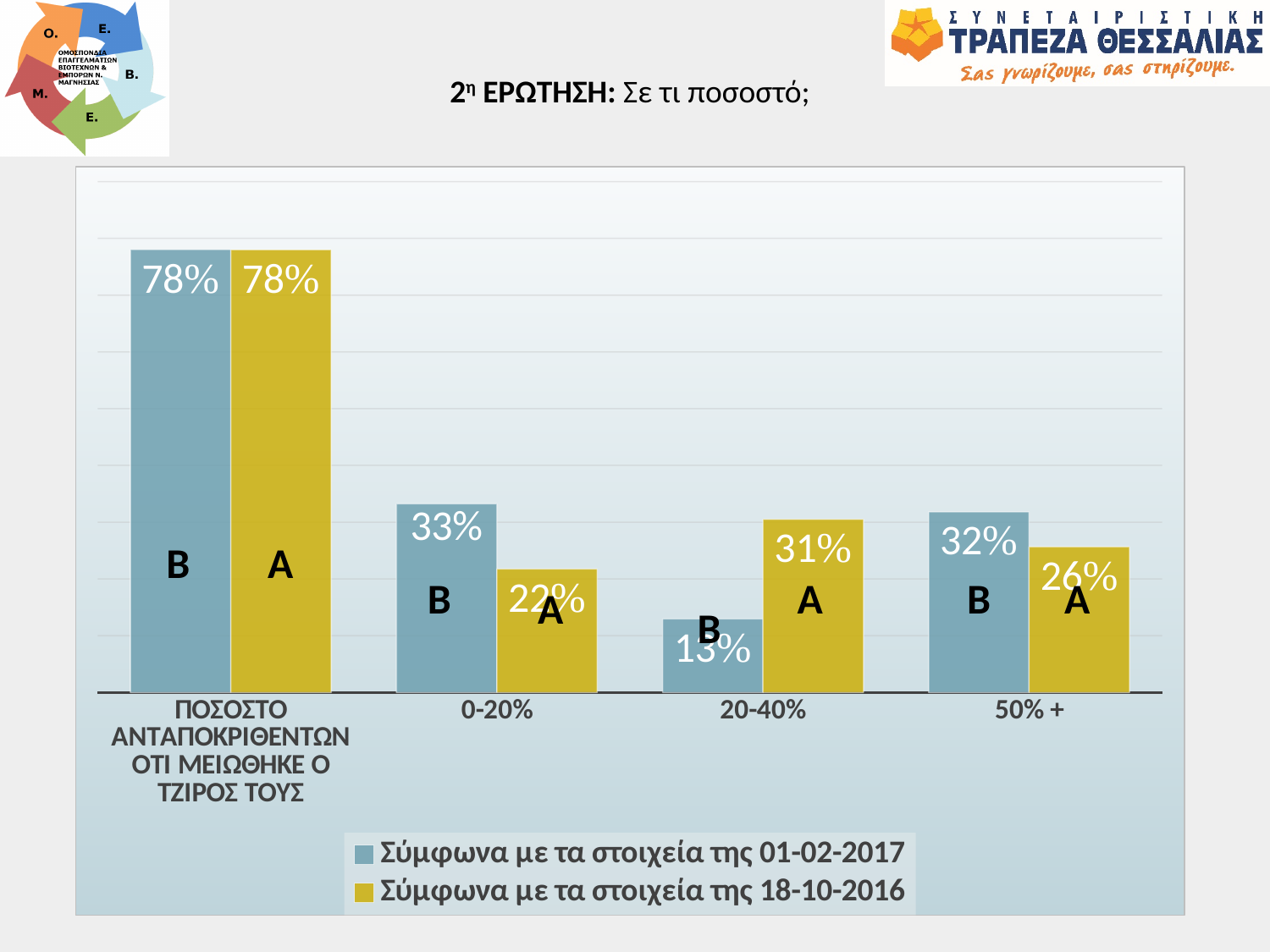
What is the value for the 0-20% category in the series 'Σύμφωνα με τα στοιχεία της 01-02-2017'? 33% Which category has the lowest value in the series 'Σύμφωνα με τα στοιχεία της 01-02-2017'? 20-40% What kind of chart is shown on the slide? bar chart What is the value for the 50% + category in the series 'Σύμφωνα με τα στοιχεία της 01-02-2017'? 32% Which category has the highest value in the series 'Σύμφωνα με τα στοιχεία της 18-10-2016'? ΠΟΣΟΣΤΟ ΑΝΤΑΠΟΚΡΙΘΕΝΤΩΝ ΟΤΙ ΜΕΙΩΘΗΚΕ Ο ΤΖΙΡΟΣ ΤΟΥΣ What is the value for the 20-40% category in the series 'Σύμφωνα με τα στοιχεία της 18-10-2016'? 31% For the 0-20% category, which series has the larger value? Σύμφωνα με τα στοιχεία της 01-02-2017 What is the value for the 0-20% category in the series 'Σύμφωνα με τα στοιχεία της 18-10-2016'? 22% How many categories are shown on the x axis? 4 How many series does the legend list? 2 What is the difference between the two series' values for the 20-40% category? 18% Which colour represents the series 'Σύμφωνα με τα στοιχεία της 18-10-2016'? yellow